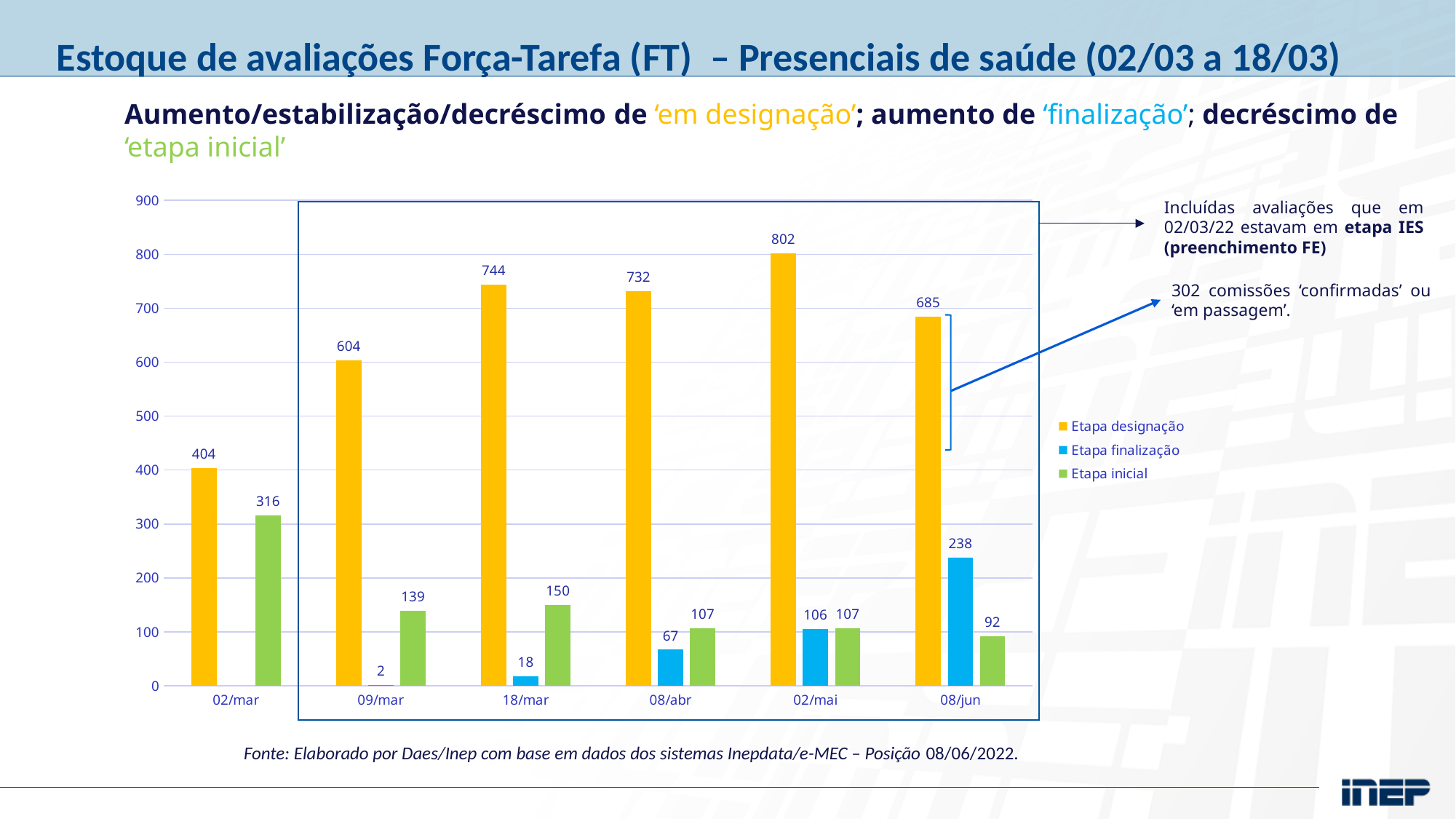
What is the value of Etapa designação on 02/mai? 802 How many dates are shown on the x axis? 6 What is the difference between Etapa designação on 18/mar and on 09/mar? 140 Does Etapa finalização rise or fall from 09/mar to 08/jun? Rise On which date is Etapa inicial lowest? 08/jun On which date is Etapa designação highest? 02/mai What kind of chart is shown? Bar chart Which is larger: Etapa finalização on 02/mai or Etapa inicial on 02/mai? Etapa inicial How many series does the legend list? 3 What is the value of Etapa finalização on 08/jun? 238 What is the value of Etapa inicial on 02/mar? 316 Which colour represents Etapa inicial in the legend? Green